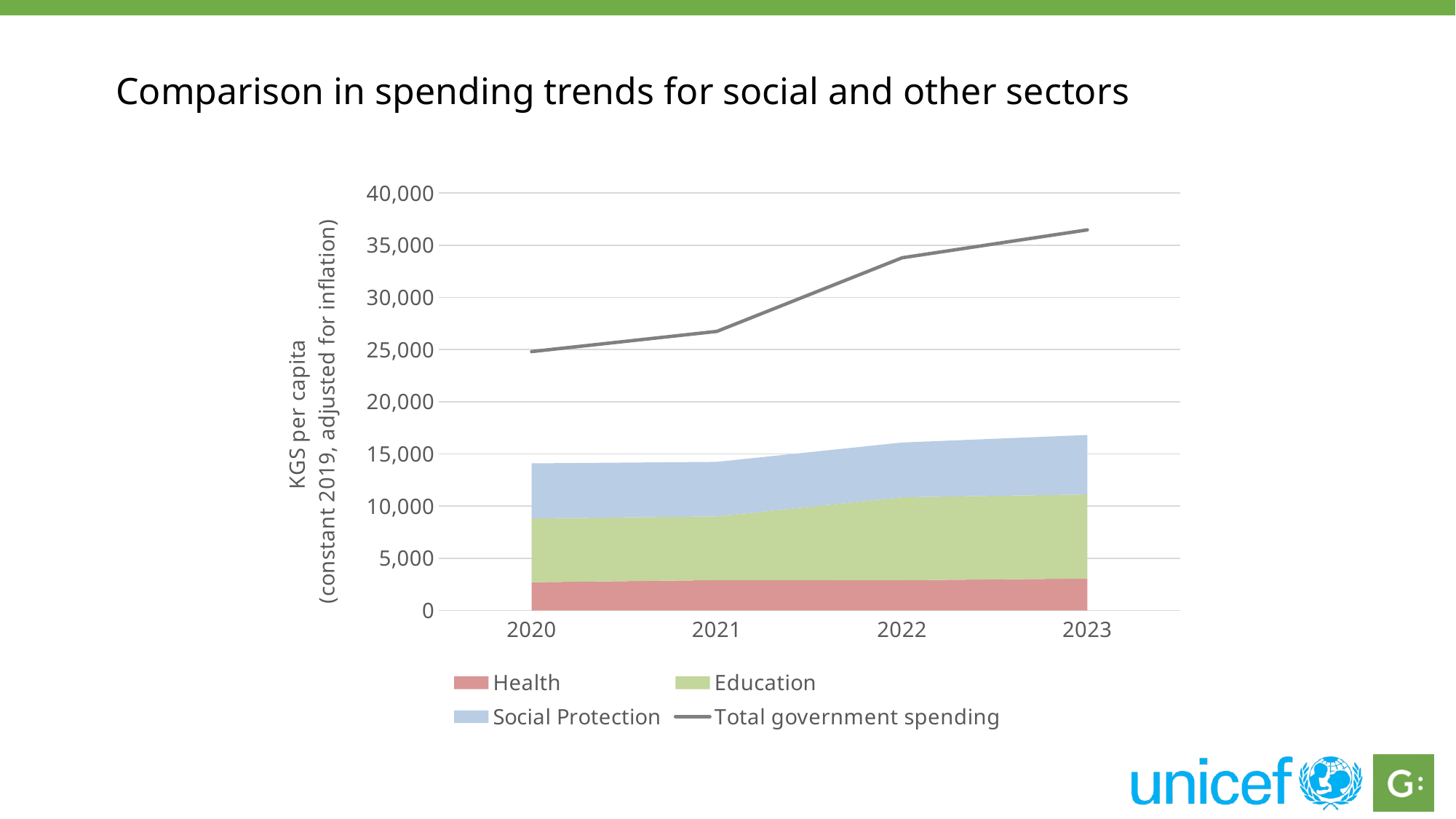
Is the value for Health in 2023 greater or less than 5,000? less Is the combined top of the stacked social sector areas in 2020 greater or less than 15,000? less How many series does the legend list? 4 Does Total government spending rise or fall from 2020 to 2023? rise How many years are shown on the x axis? 4 Is the value for Total government spending in 2023 greater or less than 35,000? greater What kind of chart is shown on the slide? stacked area chart with a line What is the label on the y axis? KGS per capita (constant 2019, adjusted for inflation)